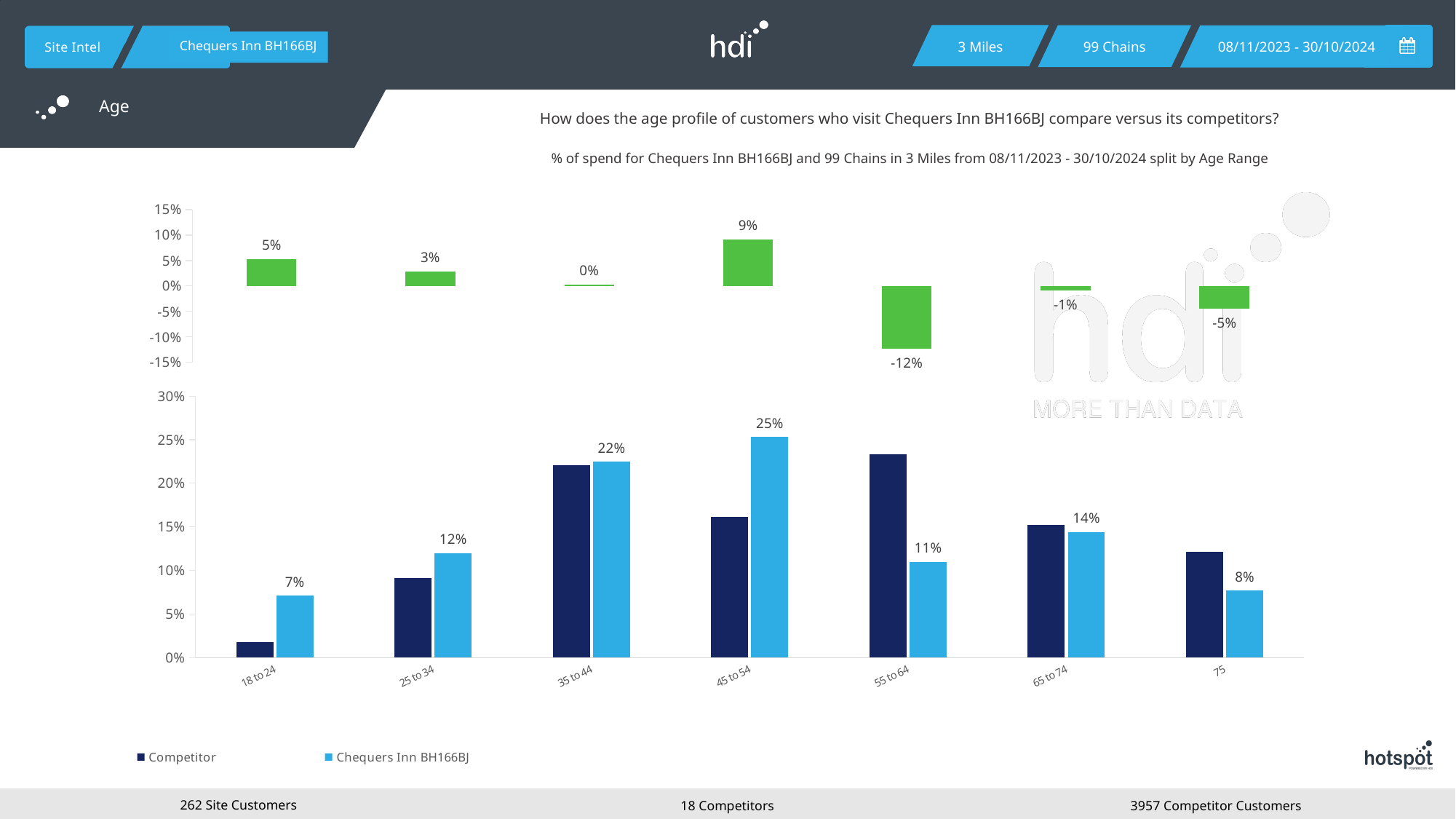
In the bottom chart, what is the value for Chequers Inn BH166BJ in the 45 to 54 age range? 25% In the bottom chart, what is the difference between the Chequers Inn BH166BJ values for 45 to 54 and 55 to 64? 14% In the bottom chart, is the Competitor value for 55 to 64 greater or less than 20%? greater How many series does the legend of the bottom chart list? 2 In the top chart, what is the value shown for the 55 to 64 age range? -12% In the top chart, what is the value shown for the 45 to 54 age range? 9% In the top chart, which age range has the lowest value? 55 to 64 In the bottom chart, which age range has the highest value for Chequers Inn BH166BJ? 45 to 54 In the bottom chart, what is the value for Chequers Inn BH166BJ in the 18 to 24 age range? 7% What type of chart is the bottom chart? Bar chart In the bottom chart, which is larger for the 55 to 64 age range: Competitor or Chequers Inn BH166BJ? Competitor How many age range categories are shown on the x axis of the bottom chart? 7